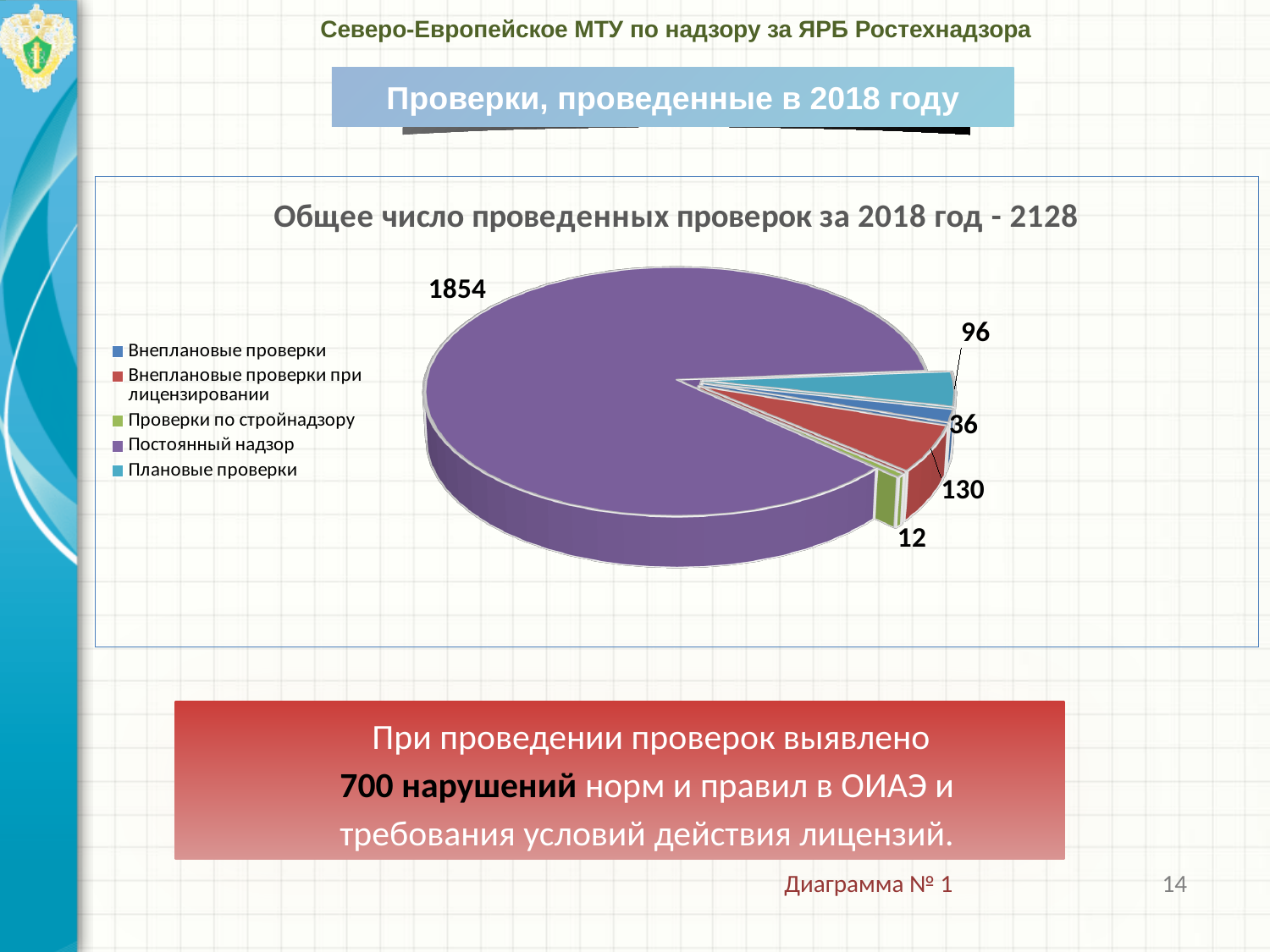
Which category has the largest slice in the pie chart? Постоянный надзор What total number of inspections for 2018 is stated in the chart title? 2128 Which is larger: Плановые проверки or Внеплановые проверки? Плановые проверки How many categories does the pie chart show? 5 What is the difference between the values for Внеплановые проверки при лицензировании and Плановые проверки? 34 What kind of chart is shown on the slide? pie chart What is the value for Проверки по стройнадзору in the pie chart? 12 What is the value for Постоянный надзор in the pie chart? 1854 What is the value for Внеплановые проверки in the pie chart? 36 Which category has the smallest slice in the pie chart? Проверки по стройнадзору What is the value for Внеплановые проверки при лицензировании in the pie chart? 130 What is the value for Плановые проверки in the pie chart? 96